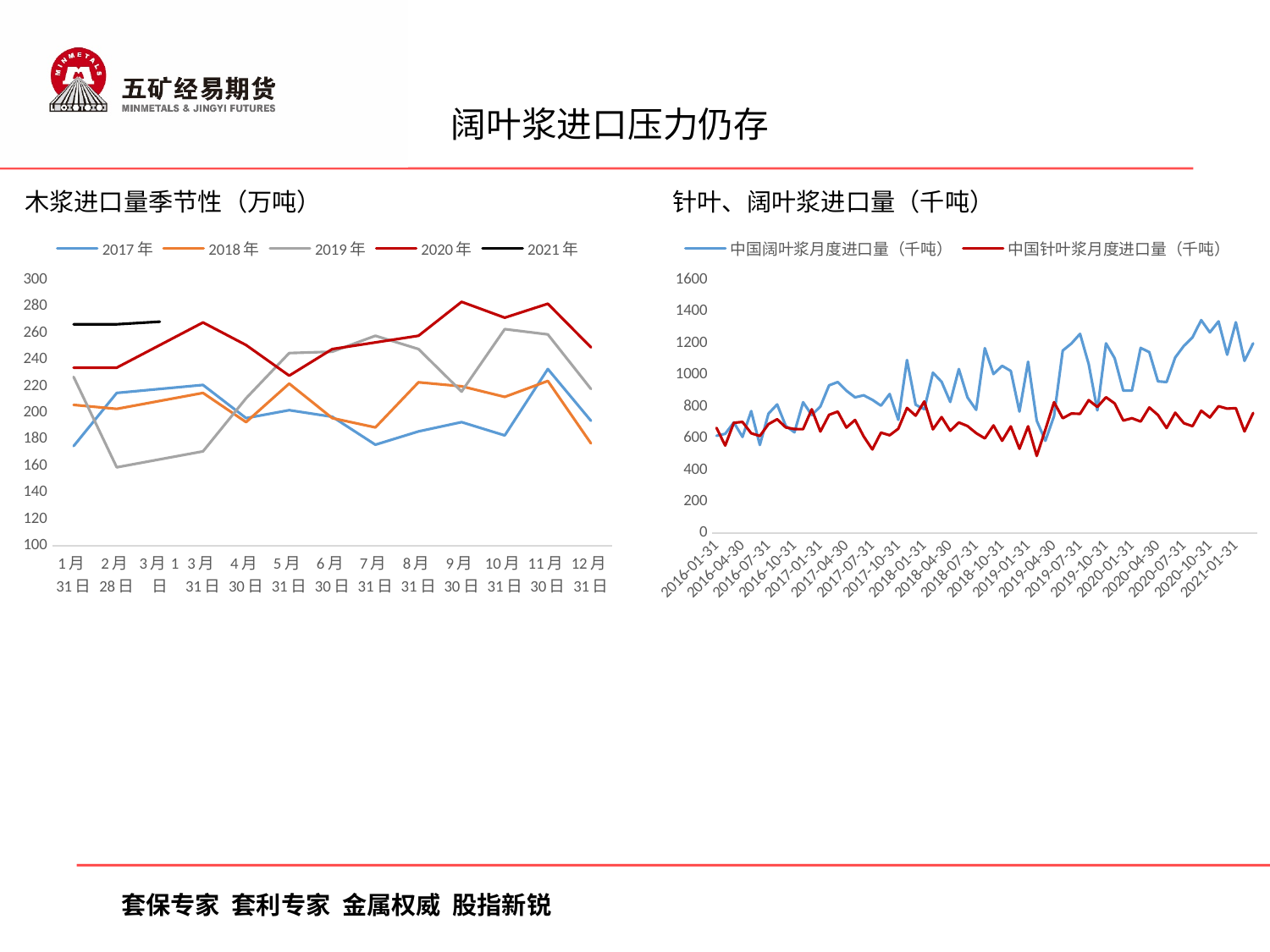
In the left chart 木浆进口量季节性（万吨）, which series has the lowest value at 2月28日? 2019年 In the left chart 木浆进口量季节性（万吨）, is the value for 2020年 at 9月30日 greater or less than 260? greater In the right chart 针叶、阔叶浆进口量（千吨）, does the 中国阔叶浆月度进口量（千吨） series generally rise or fall from 2016 to 2021? rise In the right chart 针叶、阔叶浆进口量（千吨）, is the highest value of the 中国针叶浆月度进口量（千吨） series greater or less than 1000? less How many month categories are shown on the x axis of the left chart 木浆进口量季节性（万吨）? 13 How many series does the legend of the right chart 针叶、阔叶浆进口量（千吨） list? 2 How many series does the legend of the left chart 木浆进口量季节性（万吨） list? 5 What type of chart is the left chart titled 木浆进口量季节性（万吨）? line chart In the left chart 木浆进口量季节性（万吨）, which series has the highest value at 9月30日? 2020年 In the left chart 木浆进口量季节性（万吨）, which is larger at 12月31日: the value for 2020年 or the value for 2018年? 2020年 In the left chart 木浆进口量季节性（万吨）, is the value for 2019年 at 2月28日 greater or less than 180? less In the right chart 针叶、阔叶浆进口量（千吨）, which series is drawn in red? 中国针叶浆月度进口量（千吨）